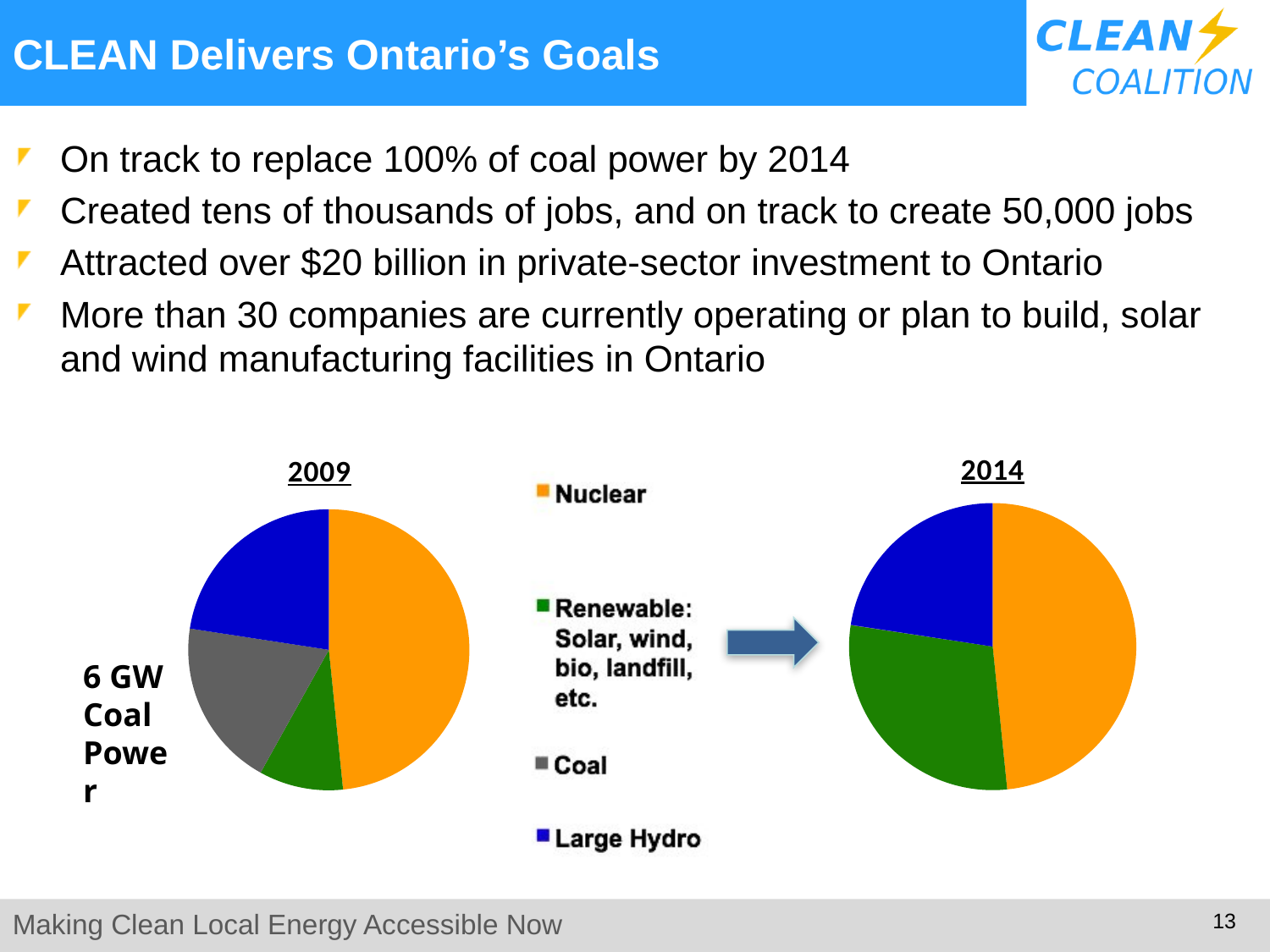
Is the Renewable slice larger in the 2009 pie chart or the 2014 pie chart? 2014 How many slices does the 2014 pie chart have? 3 In the 2009 pie chart, which category has the largest slice? Nuclear In the 2009 pie chart, which is larger, the Coal slice or the Renewable slice? Coal What kind of chart is the 2014 chart? pie chart How many slices does the 2009 pie chart have? 4 In the 2009 pie chart, which category has the smallest slice? Renewable How many entries does the shared legend list? 4 What kind of chart is the 2009 chart? pie chart What colour represents Large Hydro in the pie charts? blue Which category from the legend does not appear in the 2014 pie chart? Coal In the 2014 pie chart, which category has the largest slice? Nuclear